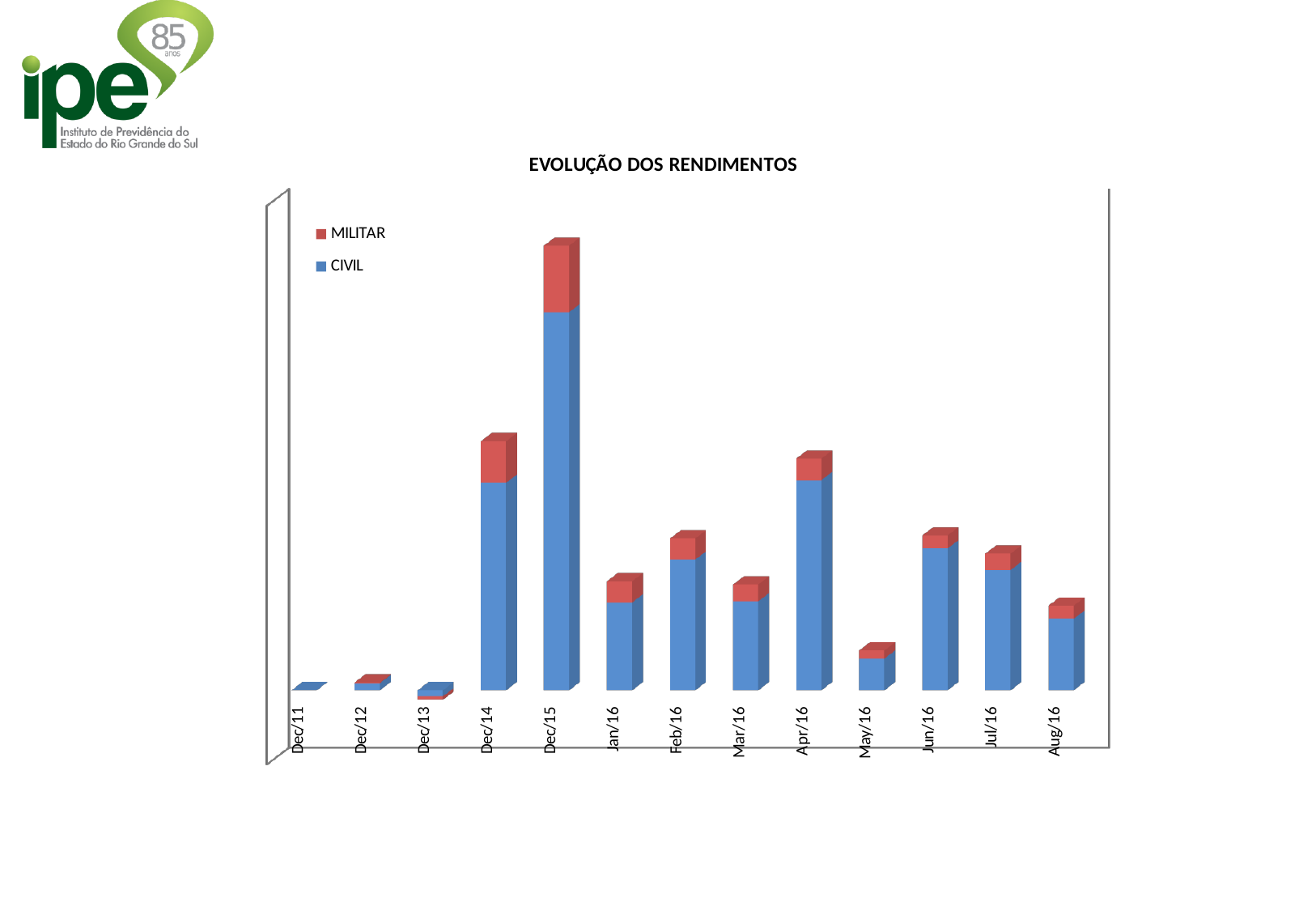
Which series is shown in red in the legend? MILITAR Which bar is taller, Dec/14 or Dec/15? Dec/15 Do the bars rise or fall from Apr/16 to May/16? Fall Which bar is taller, Jul/16 or Aug/16? Jul/16 Which bar is taller, Jan/16 or Feb/16? Feb/16 Which category has the highest total bar? Dec/15 How many categories are shown on the x axis? 13 What is the title of the chart? EVOLUÇÃO DOS RENDIMENTOS Do the bars rise or fall from Jun/16 to Aug/16? Fall How many series does the legend list? 2 What kind of chart is shown on the slide? Stacked bar chart